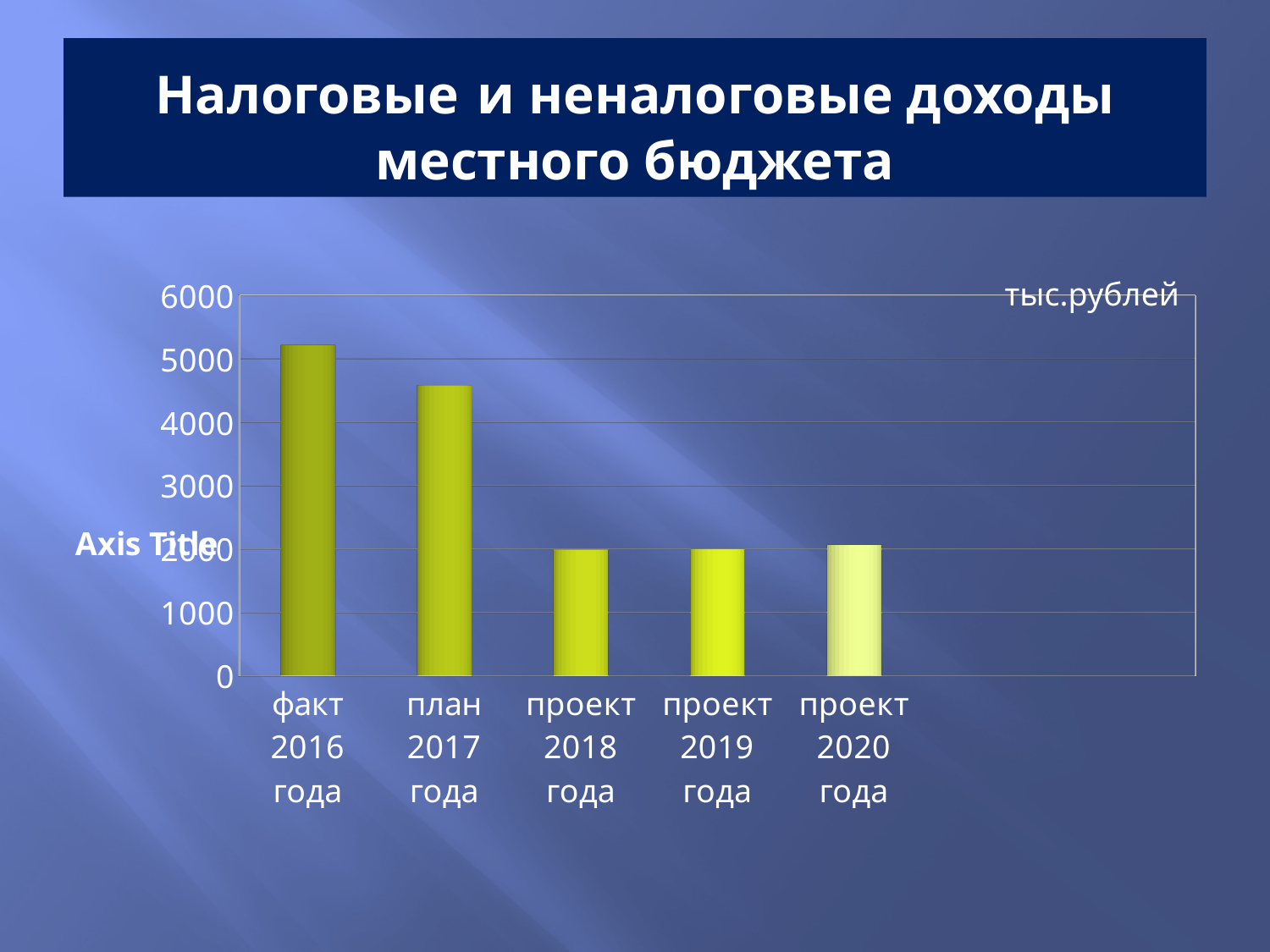
What unit is indicated in the top right corner of the chart? тыс.рублей Which is larger, the value for факт 2016 года or the value for план 2017 года? факт 2016 года Is the value for план 2017 года greater or less than 5000? less Which category has the highest value in the chart? факт 2016 года How many categories are shown on the x axis of the chart? 5 Is the value for план 2017 года greater or less than 4000? greater Is the value for проект 2018 года greater or less than 3000? less Which is larger, the value for план 2017 года or the value for проект 2020 года? план 2017 года Do the values rise or fall from факт 2016 года to проект 2018 года? fall What kind of chart is shown on the slide? bar chart